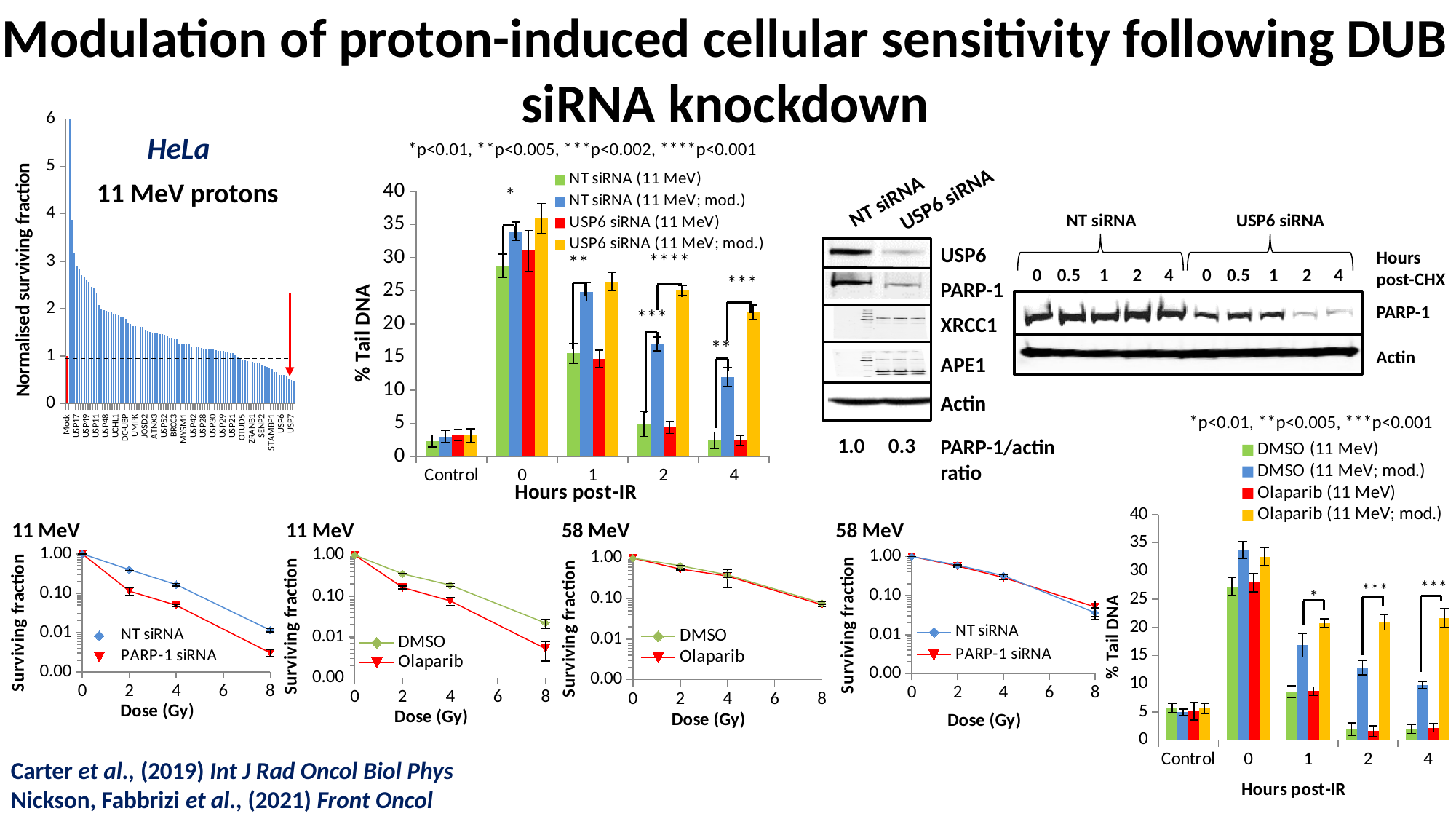
What kind of chart is the leftmost '11 MeV' Surviving fraction chart at the bottom of the slide? line chart In the top-middle '% Tail DNA' bar chart with the siRNA legend, does the NT siRNA (11 MeV) series rise or fall from 0 to 4 hours post-IR? fall In the top-middle '% Tail DNA' bar chart with the siRNA legend, is the value for NT siRNA (11 MeV) at 4 hours post-IR greater or less than 5? less In the top-middle '% Tail DNA' bar chart (Hours post-IR, siRNA legend), how many series does the legend list? 4 In the top-middle '% Tail DNA' bar chart with the siRNA legend, is the value for NT siRNA (11 MeV; mod.) at 0 hours post-IR greater or less than 30? greater In the bottom-right '% Tail DNA' bar chart (DMSO/Olaparib legend), is the value for DMSO (11 MeV; mod.) at 0 hours post-IR greater or less than 30? greater In the top-middle '% Tail DNA' bar chart with the siRNA legend, how many categories are shown on the x axis? 5 In the top-middle '% Tail DNA' bar chart with the siRNA legend, at 2 hours post-IR, which is larger: NT siRNA (11 MeV; mod.) or USP6 siRNA (11 MeV)? NT siRNA (11 MeV; mod.) In the bottom-right '% Tail DNA' bar chart (DMSO/Olaparib legend), at 2 hours post-IR, which is larger: DMSO (11 MeV; mod.) or Olaparib (11 MeV; mod.)? Olaparib (11 MeV; mod.) In the bottom-right '% Tail DNA' bar chart (DMSO/Olaparib legend), how many series does the legend list? 4 In the leftmost '11 MeV' Surviving fraction line chart, which series is higher at 8 Gy: NT siRNA or PARP-1 siRNA? NT siRNA